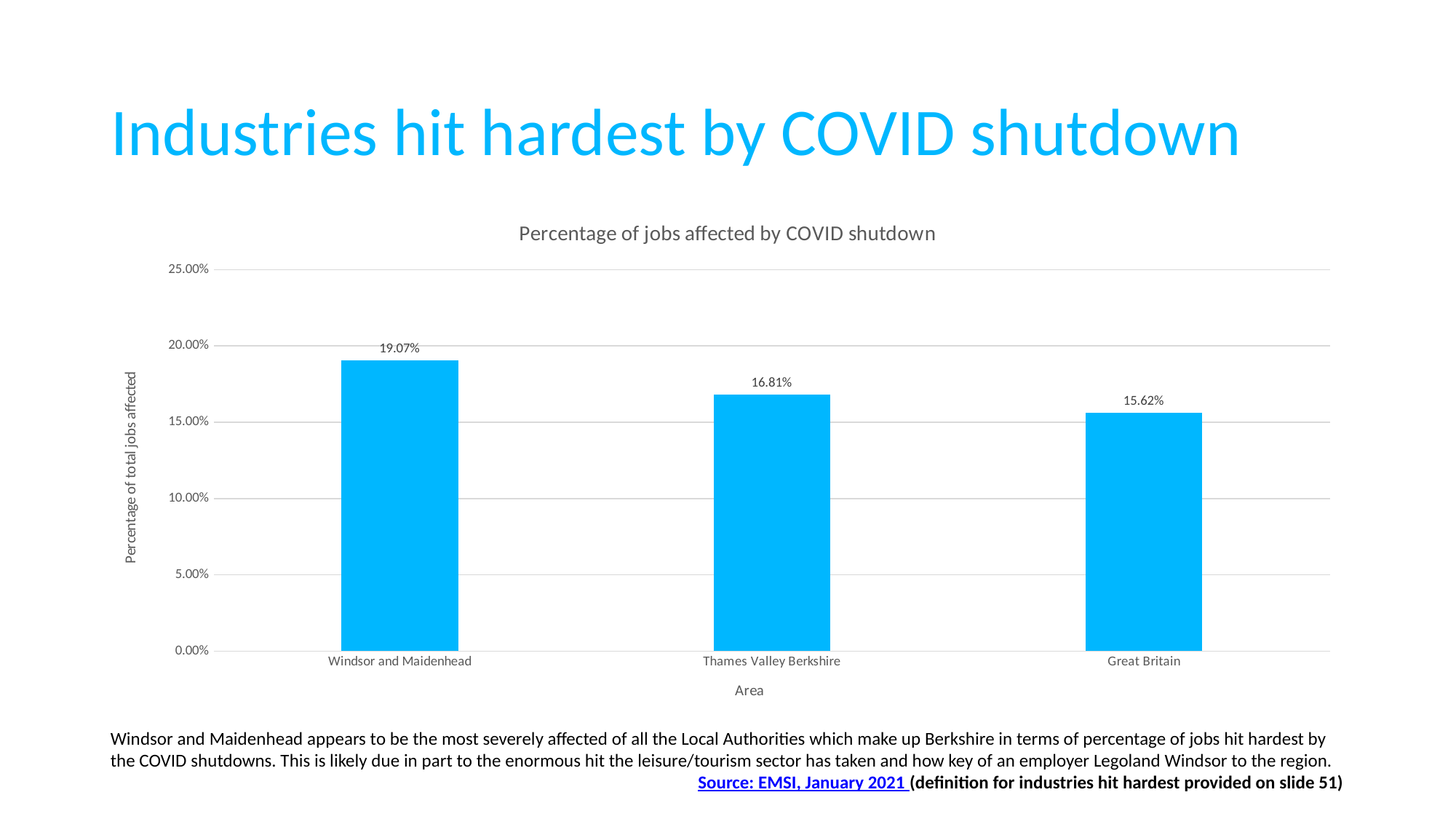
Is the value for Windsor and Maidenhead greater or less than 20.00%? less What kind of chart is shown on the slide? Bar chart What is the title of the chart? Percentage of jobs affected by COVID shutdown What is the difference in percentage points between Windsor and Maidenhead and Thames Valley Berkshire? 2.26% What is the percentage of jobs affected by COVID shutdown for Great Britain? 15.62% Which area has the lowest percentage of jobs affected by COVID shutdown? Great Britain Which has a higher percentage of jobs affected: Thames Valley Berkshire or Great Britain? Thames Valley Berkshire What is the percentage of jobs affected by COVID shutdown for Thames Valley Berkshire? 16.81% How many areas are shown on the chart? 3 What is the difference in percentage points between Windsor and Maidenhead and Great Britain? 3.45% Which area has the highest percentage of jobs affected by COVID shutdown? Windsor and Maidenhead What is the percentage of jobs affected by COVID shutdown for Windsor and Maidenhead? 19.07%